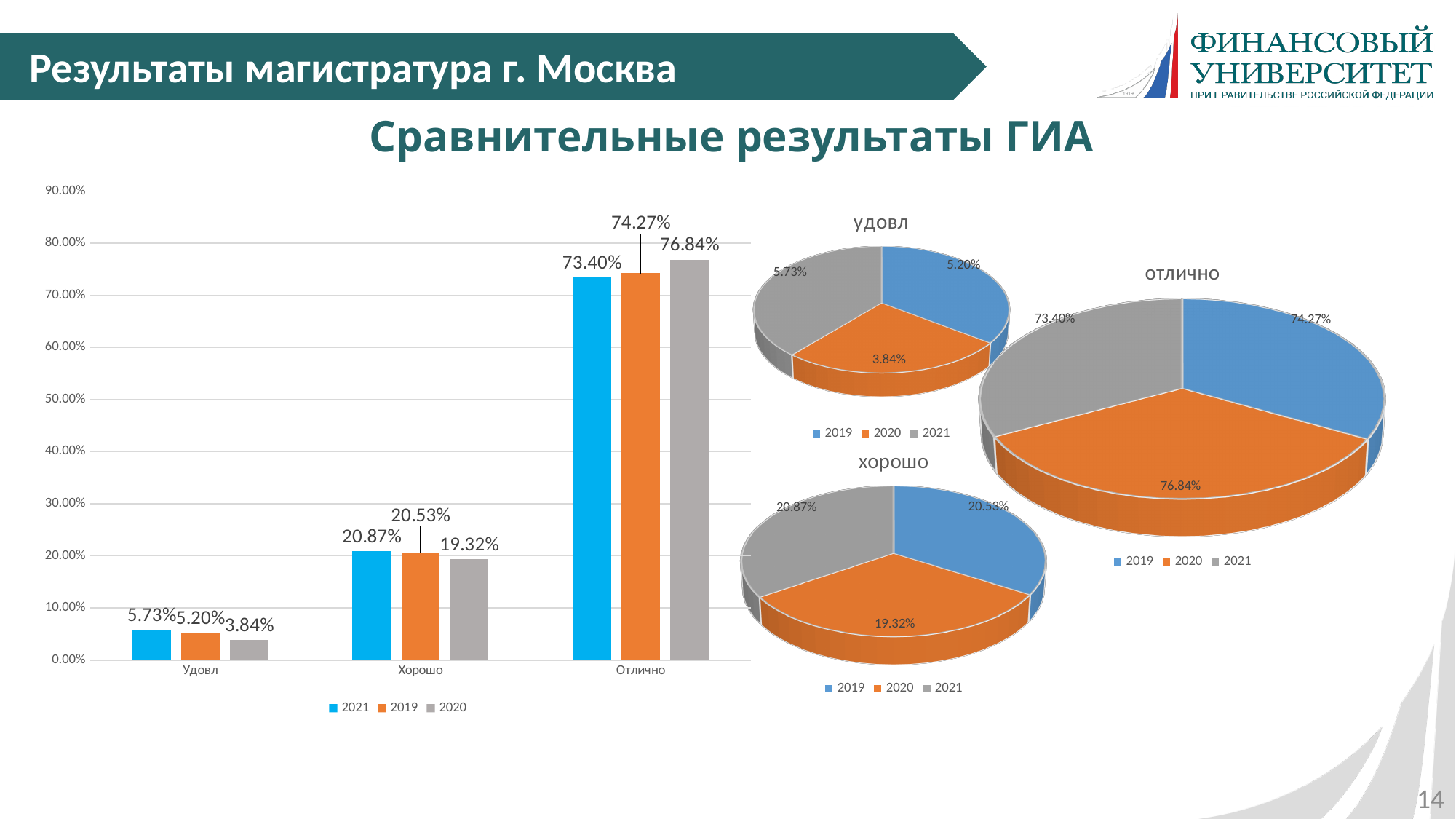
In the bar chart on the left, what is the difference between the 2020 and 2021 values in the Отлично category? 3.44% In the bar chart on the left, what is the value for 2019 in the Хорошо category? 20.53% In the bar chart on the left, which year has the highest value in the Отлично category? 2020 In the pie chart titled 'хорошо', what is the share for 2020? 19.32% How many categories are shown on the x axis of the bar chart on the left? 3 How many series does the legend of the bar chart on the left list? 3 What kind of chart is the chart titled 'отлично'? Pie chart In the bar chart on the left, which year has the lowest value in the Удовл category? 2020 In the bar chart on the left, which is larger: the 2021 value or the 2019 value for Хорошо? 2021 In the pie chart titled 'удовл', which year has the largest slice? 2021 In the bar chart on the left, what is the value for 2020 in the Удовл category? 3.84% In the bar chart on the left, what is the value for 2021 in the Отлично category? 73.40%